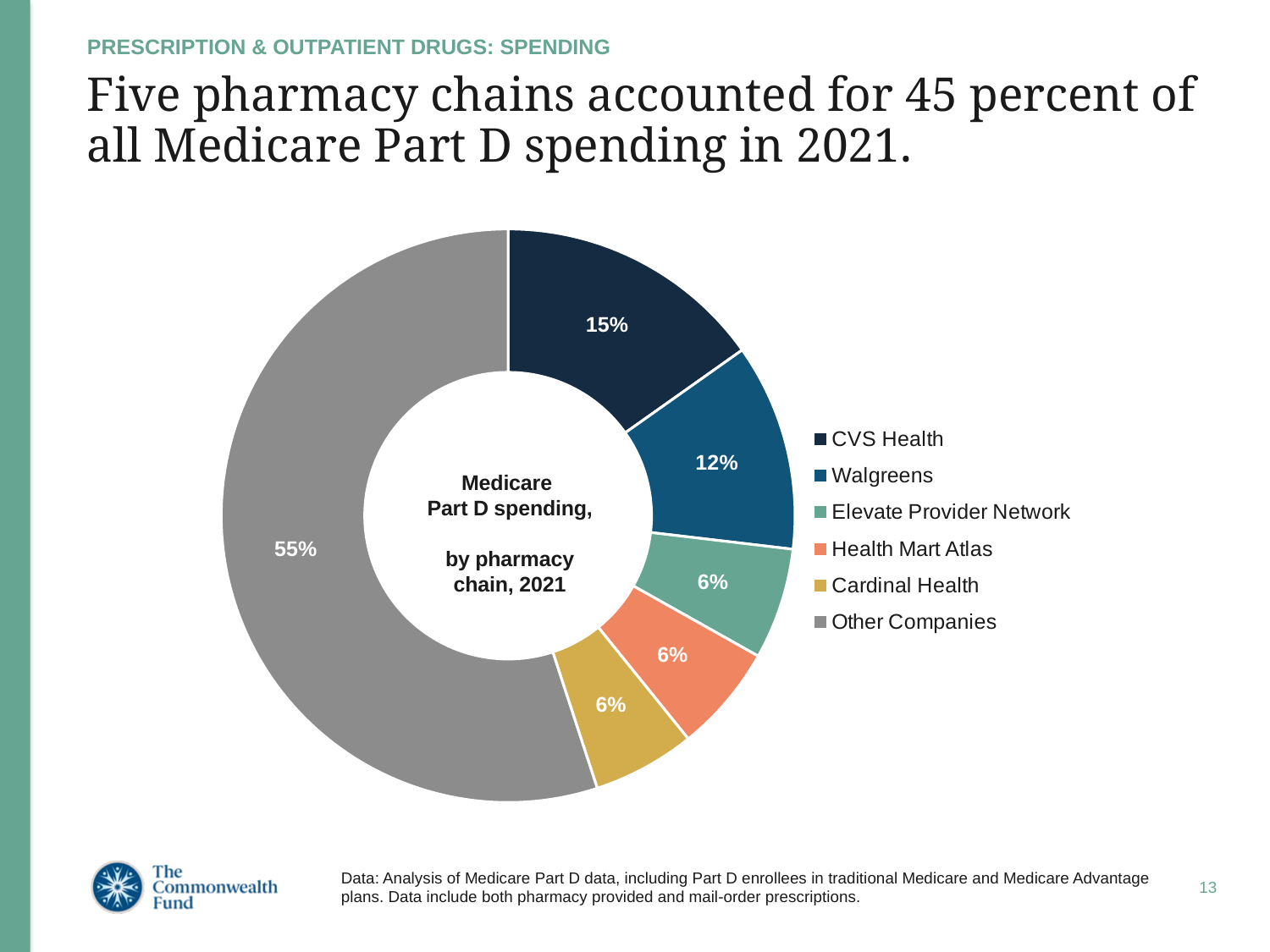
Which category has the largest share of the pie? Other Companies What is the difference in share between CVS Health and Walgreens? 3% What share of Medicare Part D spending does CVS Health account for? 15% Which has a larger share, Walgreens or Elevate Provider Network? Walgreens What share of Medicare Part D spending does Walgreens account for? 12% Which named pharmacy chain has the largest share of Medicare Part D spending? CVS Health What share of Medicare Part D spending is attributed to Other Companies? 55% What kind of chart is shown on the slide? Pie chart (donut) What text appears in the center of the donut chart? Medicare Part D spending, by pharmacy chain, 2021 What is the difference in share between Other Companies and CVS Health? 40% What share of Medicare Part D spending does Cardinal Health account for? 6% How many categories does the legend list? 6